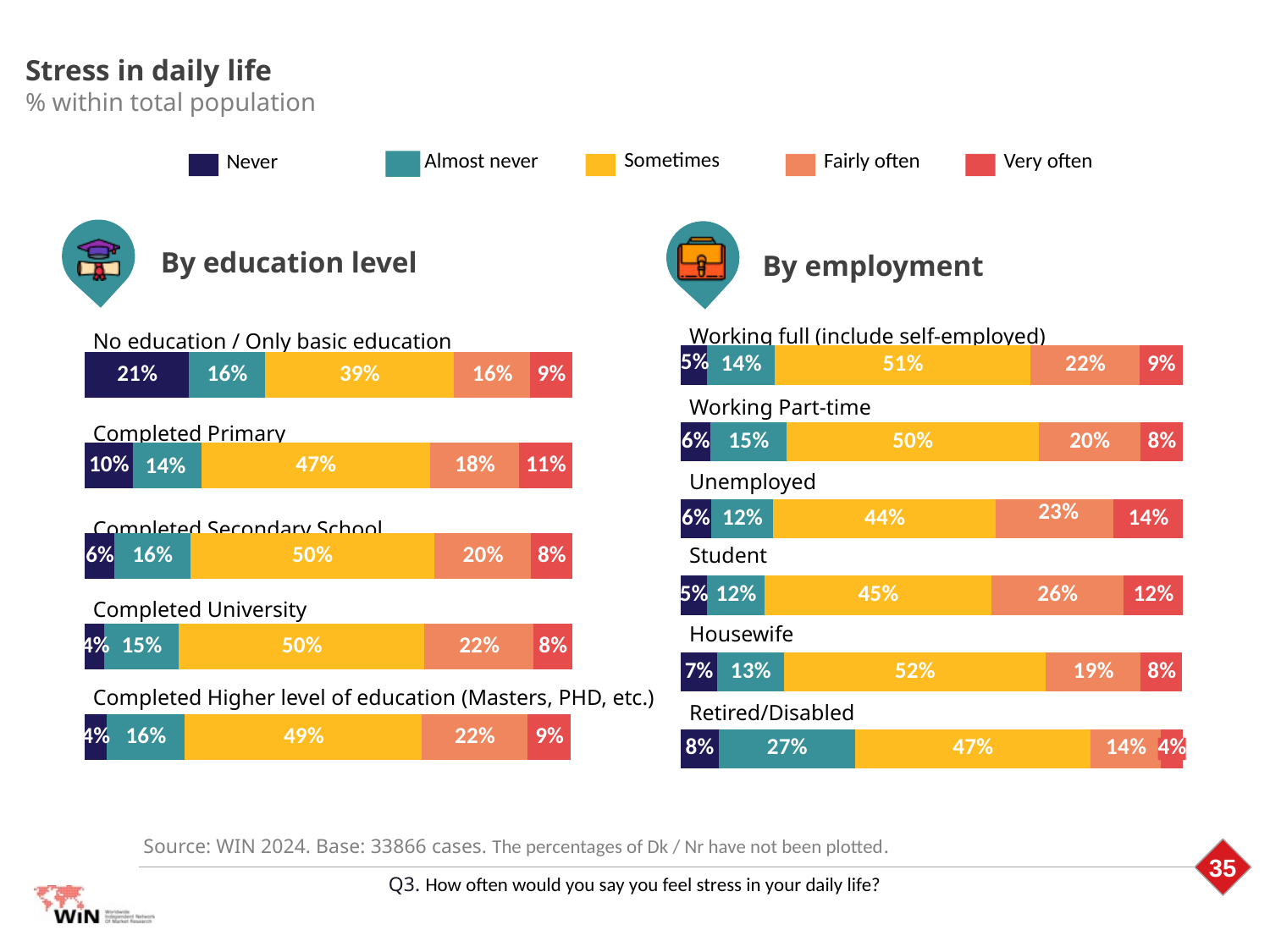
In the 'By employment' chart, which is larger: the 'Fairly often' value for Students or for Unemployed? Students In the 'By education level' chart, what is the difference between the 'Sometimes' values for Completed Primary and No education / Only basic education? 8% In the 'By employment' chart, what percentage of Housewives say they 'Sometimes' feel stress? 52% How many employment categories are shown in the 'By employment' chart? 6 In the 'By employment' chart, which employment group has the lowest 'Very often' value? Retired/Disabled How many series does the legend list? 5 In the 'By employment' chart, what is the total of the plotted values for the Retired/Disabled bar? 100% In the 'By education level' chart, what percentage of people with no education / only basic education say they 'Never' feel stress? 21% What kind of chart is used on this slide? Stacked bar chart In the 'By employment' chart, which employment group has the highest 'Almost never' value? Retired/Disabled Which colour represents 'Sometimes' in the legend? Yellow How many education categories are shown in the 'By education level' chart? 5